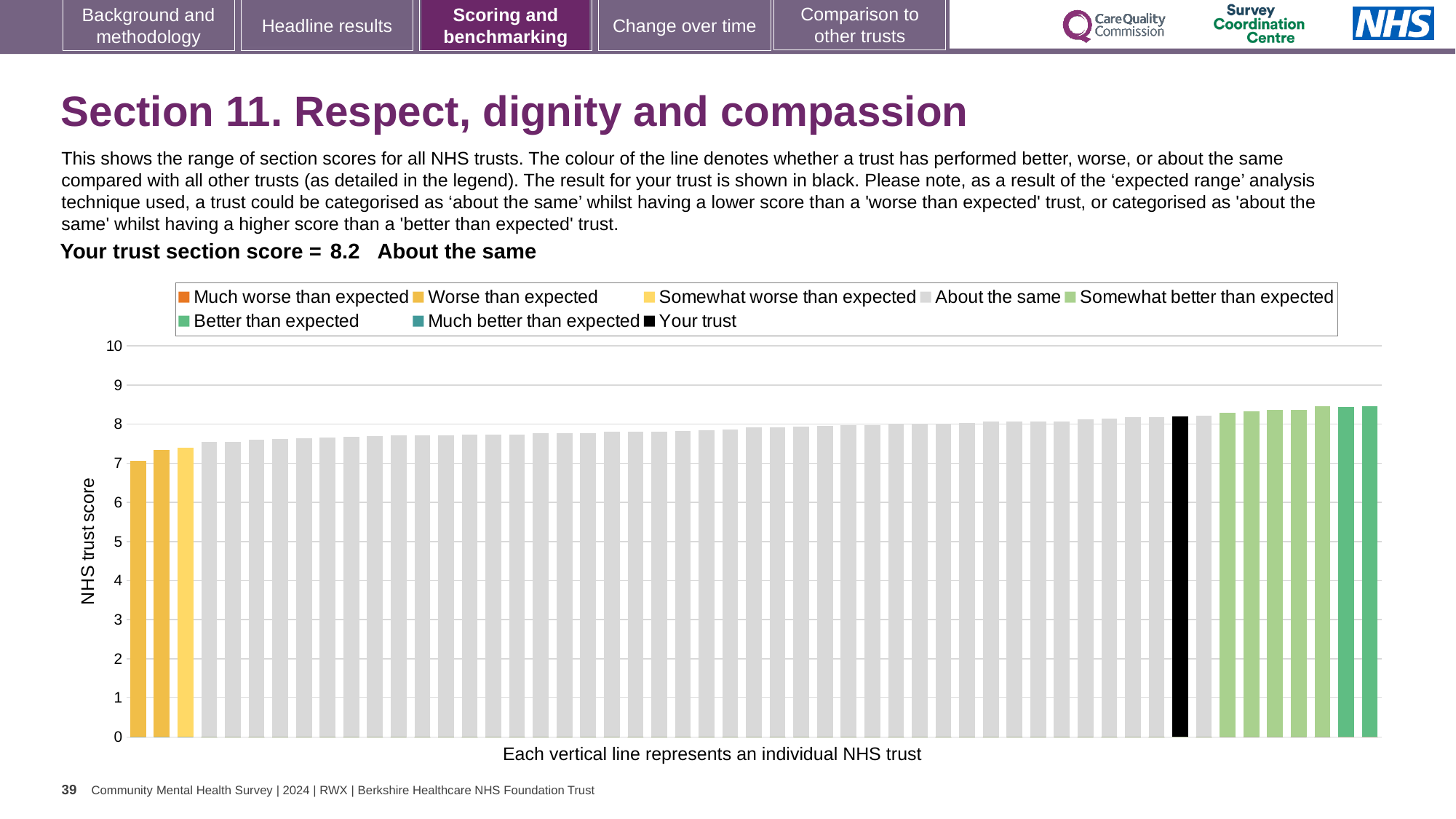
What is the label on the vertical axis of the chart? NHS trust score Which performance category is your trust placed in for Section 11? About the same What kind of chart is shown on the slide? bar chart Is the value for your trust greater or less than 5? greater What colour is the bar representing your trust? black Do the bar values rise or fall from left to right along the x axis? rise What is the section score for your trust shown on the slide? 8.2 Is the value of the rightmost (highest) bar greater or less than 9? less Is the value of the leftmost (lowest) bar greater or less than 8? less How many entries does the chart legend list? 8 What is the highest value shown on the vertical axis? 10